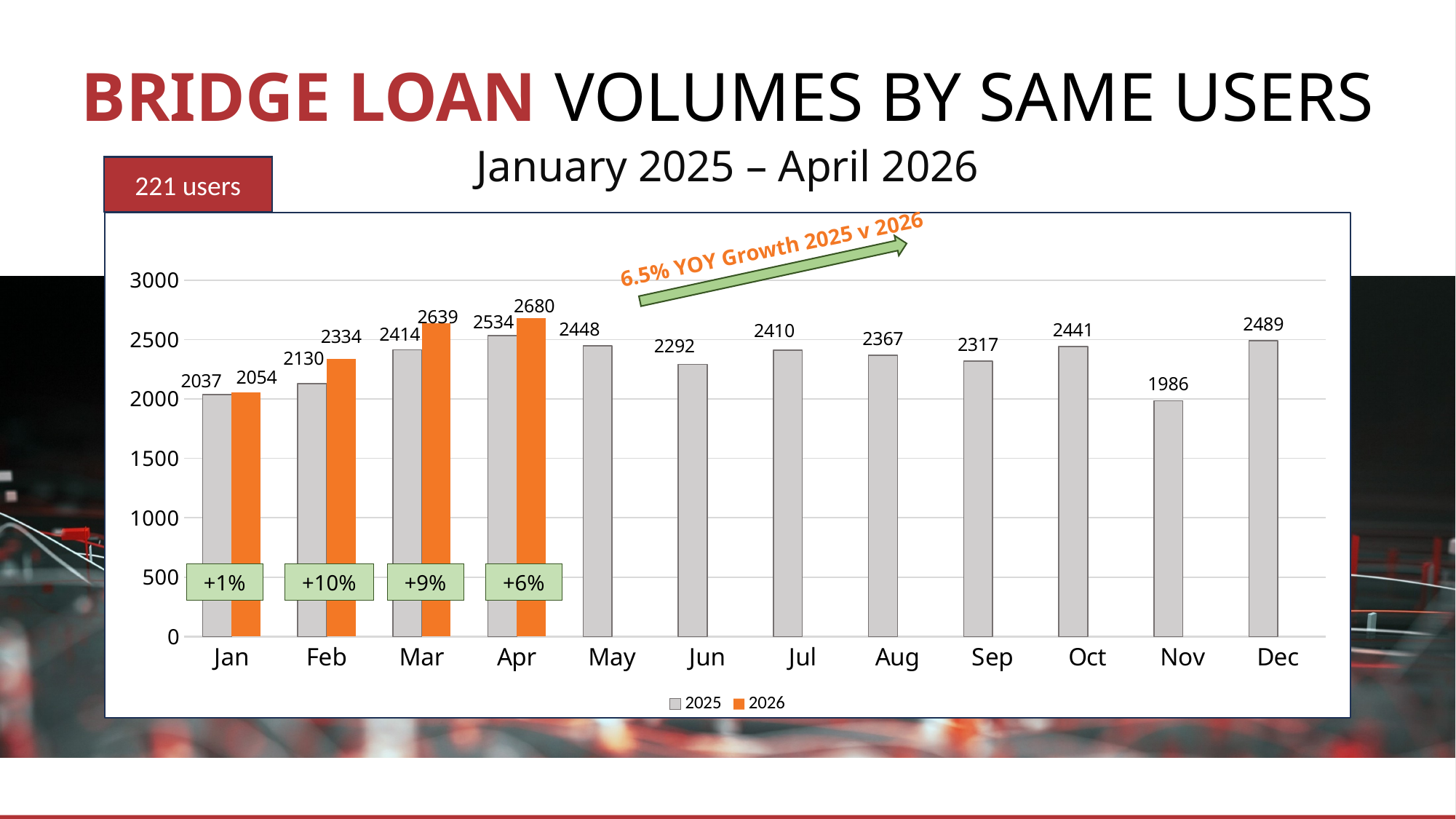
Is the 2025 value for Jun greater or less than 2500? less Which is larger, the 2025 value for Dec or the 2025 value for Oct? Dec What is the 2025 value for Nov? 1986 What is the difference between the 2026 and 2025 values for Feb? 204 Which month has the highest 2026 value? Apr How many series does the legend list? 2 What is the 2026 value for Mar? 2639 Which month has the lowest 2025 value? Nov What is the 2025 value for Jan? 2037 What YOY growth figure is annotated on the chart? 6.5% YOY Growth 2025 v 2026 What kind of chart is shown? bar chart How many months are shown on the x axis? 12